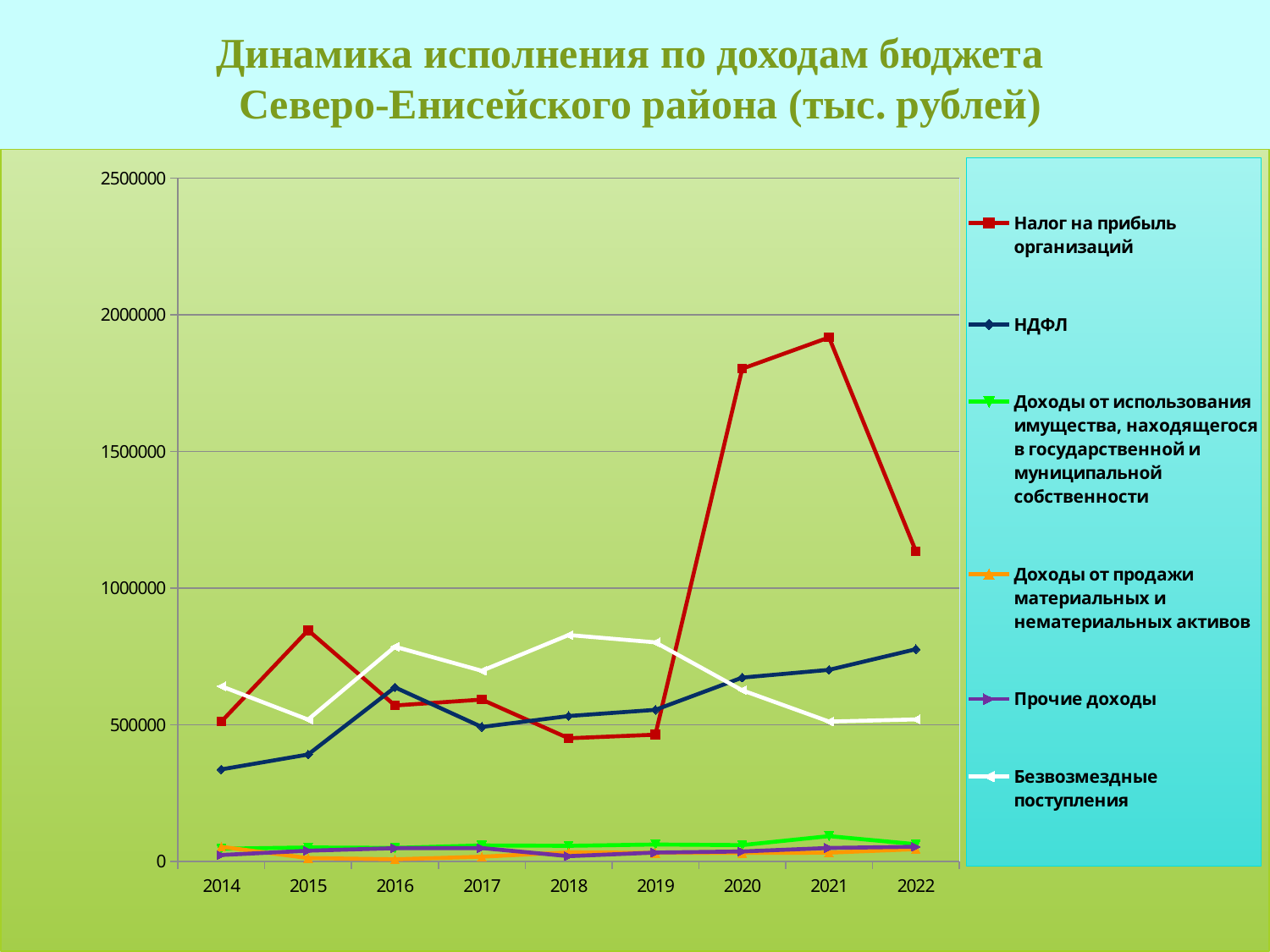
What kind of chart is shown on the slide? line chart Does НДФЛ rise or fall from 2017 to 2022? rises In which year is НДФЛ lowest? 2014 Is the value for Безвозмездные поступления in 2018 greater or less than 500000? greater Is the value for Налог на прибыль организаций in 2022 greater or less than 1000000? greater In 2020, which is larger: Налог на прибыль организаций or НДФЛ? Налог на прибыль организаций In 2016, which is larger: Безвозмездные поступления or Налог на прибыль организаций? Безвозмездные поступления Is the value for НДФЛ in 2014 greater or less than 500000? less In which year is Налог на прибыль организаций highest? 2021 How many years are plotted along the x axis? 9 How many series does the legend list? 6